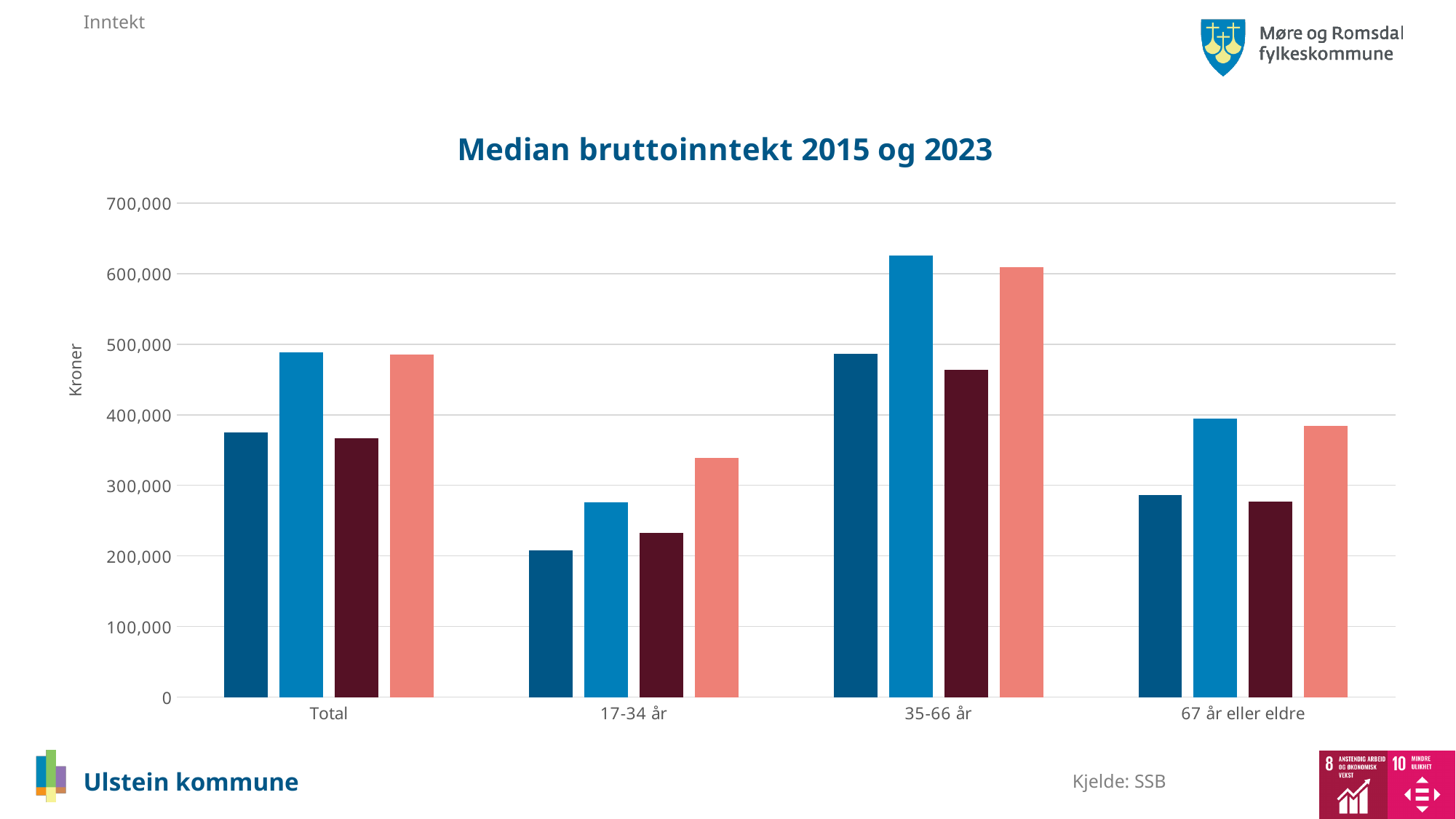
Is the value of the salmon-coloured bar for 67 år eller eldre greater or less than 400,000? less Which is larger: the dark blue bar for Total or the dark blue bar for 67 år eller eldre? Total How many bars are plotted for each category in the chart? 4 Which category contains the shortest bar in the chart? 17-34 år Is the value of the dark blue bar for 17-34 år greater or less than 300,000? less What is the title of the chart? Median bruttoinntekt 2015 og 2023 Which category contains the tallest bar in the chart? 35-66 år What is the label on the vertical axis of the chart? Kroner How many categories are shown along the x axis of the chart? 4 What kind of chart is shown on the slide? bar chart Is the value of the light blue bar for 35-66 år greater or less than 600,000? greater